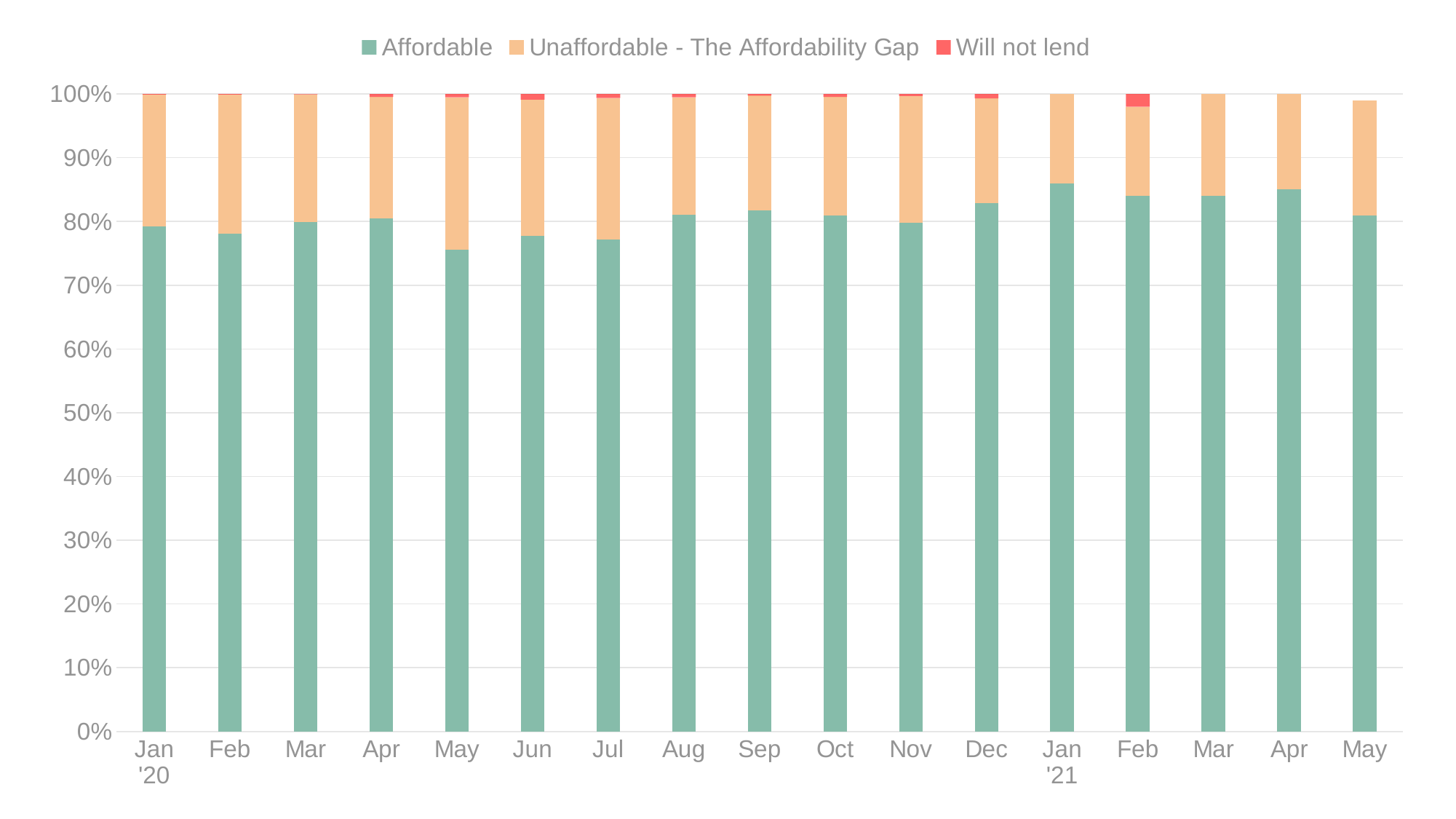
Which has the larger Affordable share, Feb '20 or Dec '20? Dec '20 Which month has the lowest Affordable share? May '20 Is the Affordable value for Jan '21 greater or less than 80%? greater How many series does the legend list? 3 What colour represents the Will not lend series in the legend? Red Is the Affordable value for May '20 greater or less than 80%? less Is the Affordable value for Feb '20 greater or less than 80%? less Which month has the largest Will not lend segment? Feb '21 Which has the larger Affordable share, May '20 or Jan '21? Jan '21 How many months are shown along the x axis? 17 What kind of chart is shown on the slide? Stacked bar chart